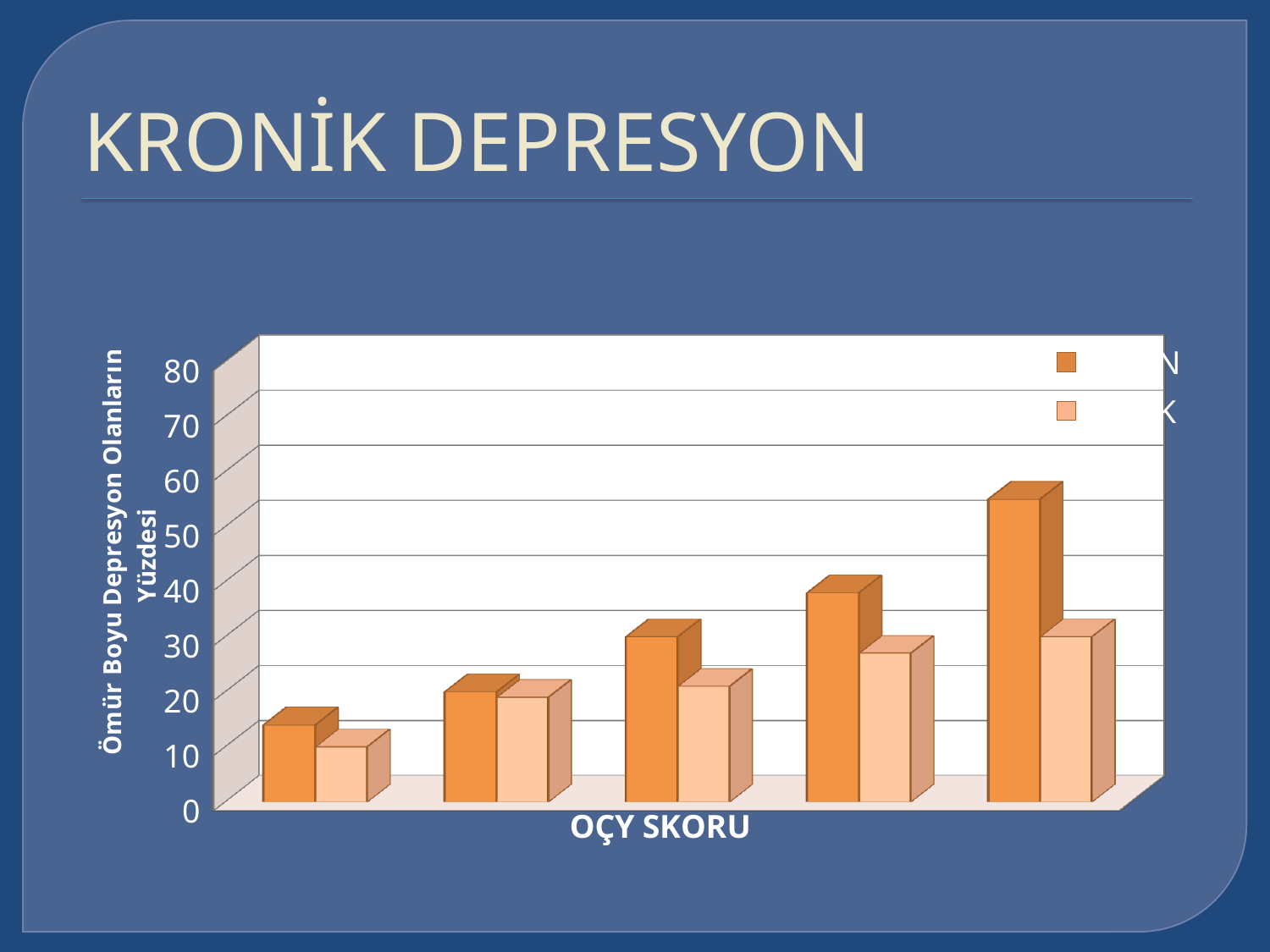
Do the dark orange bars rise or fall from left to right along the x axis? rise How many series does the legend list? 2 Is the value of the dark orange bar in the fourth group from the left greater or less than 30? greater Which group of bars, counted from the left, contains the tallest bar? the fifth (rightmost) group Which group of bars, counted from the left, contains the shortest bar? the first (leftmost) group What kind of chart is shown on the slide? bar chart What is the title of the x axis? OÇY SKORU What is the title of the y axis? Ömür Boyu Depresyon Olanların Yüzdesi In the rightmost group, is the dark orange bar or the light orange bar taller? the dark orange bar How many groups of bars are plotted along the x axis? 5 Is the value of the dark orange bar in the leftmost group greater or less than 20? less Is the value of the dark orange bar in the rightmost group greater or less than 50? greater